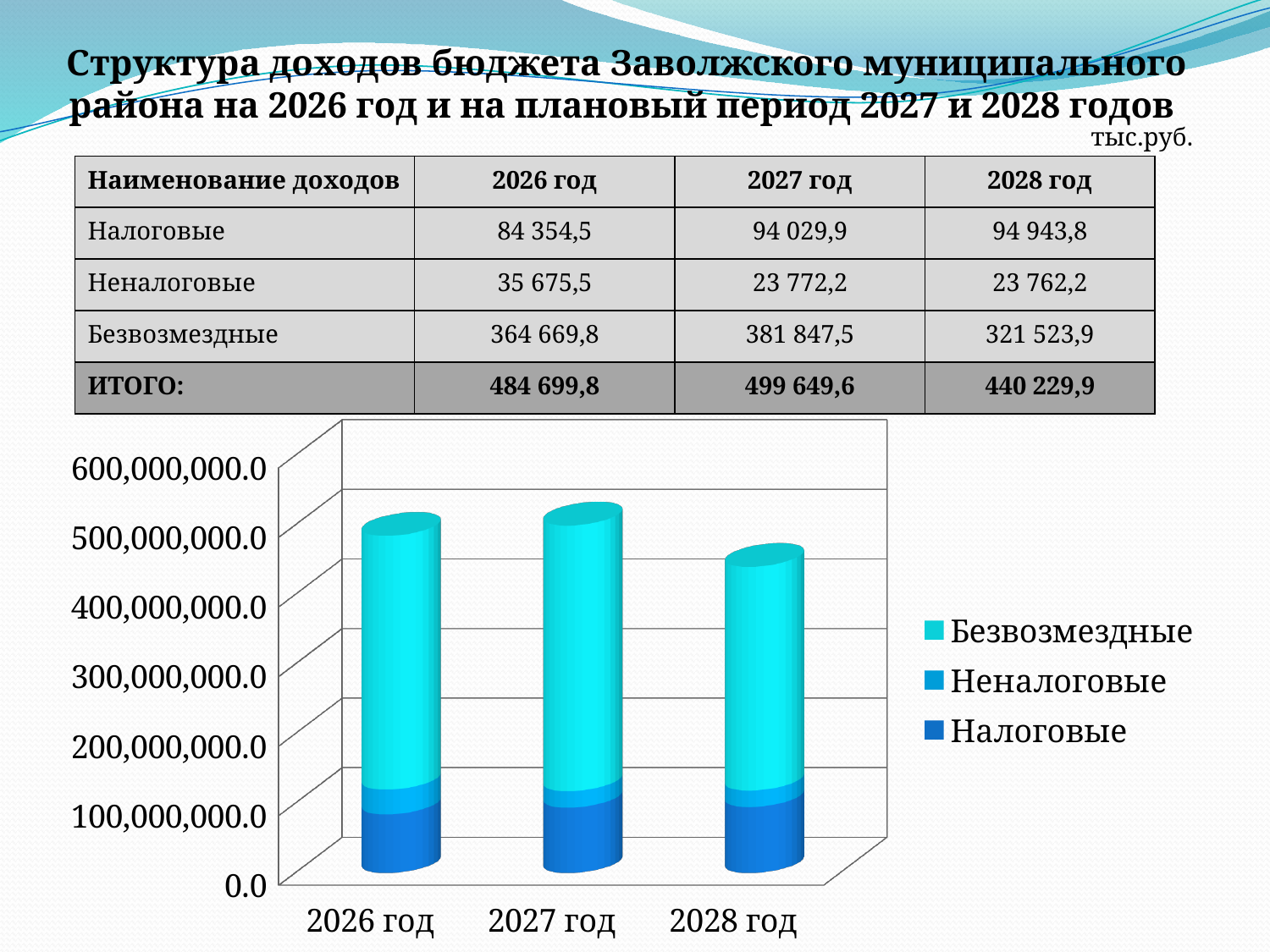
How many years (categories) are shown on the x axis of the chart? 3 What kind of chart is shown on the slide? stacked bar chart How many series does the chart legend list? 3 Is the total bar for 2027 год greater or less than 600,000,000.0? less Which series are listed in the chart legend? Безвозмездные, Неналоговые, Налоговые Is the Безвозмездные segment for 2027 год larger or smaller than the Налоговые segment for 2027 год? larger Which series makes up the largest part of each bar in the chart? Безвозмездные Which series is drawn at the bottom of each stacked bar? Налоговые Which year has the lowest total bar in the chart? 2028 год Is the total bar for 2028 год greater or less than 500,000,000.0? less Do the total bars rise steadily from 2026 год to 2028 год? No, they rise in 2027 and then fall in 2028 Is the total bar for 2026 год greater or less than 400,000,000.0? greater